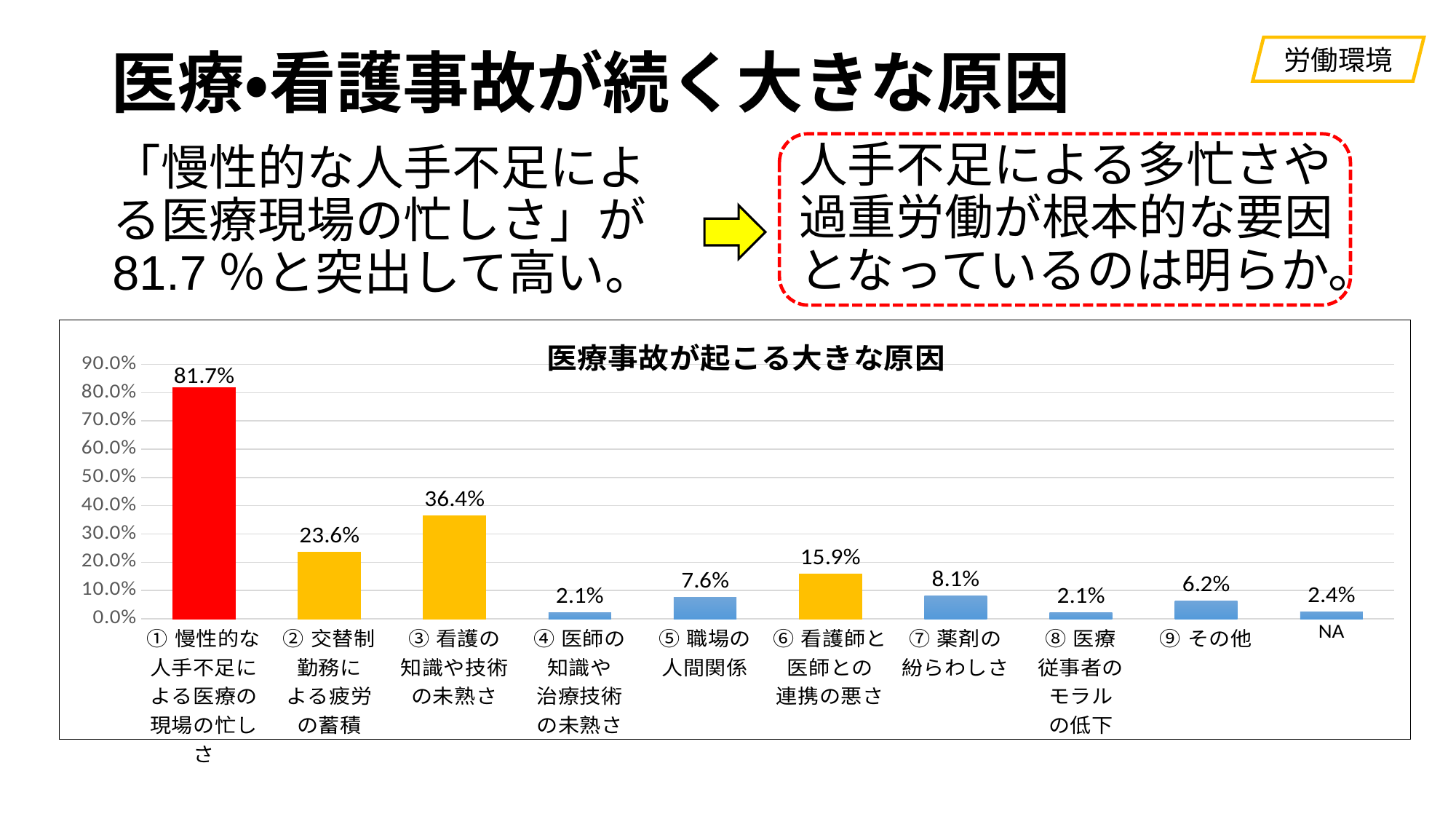
Which is larger, ② 交替制勤務による疲労の蓄積 or ⑥ 看護師と医師との連携の悪さ? ② 交替制勤務による疲労の蓄積 What is the value for NA? 2.4% What is the difference between ① 慢性的な人手不足による医療現場の忙しさ and ③ 看護の知識や技術の未熟さ? 45.3% What colour is the bar for ① 慢性的な人手不足による医療現場の忙しさ? red What is the value for ① 慢性的な人手不足による医療現場の忙しさ? 81.7% What is the title of the chart? 医療事故が起こる大きな原因 What is the value for ③ 看護の知識や技術の未熟さ? 36.4% What type of chart is shown on the slide? bar chart Is the value for ⑦ 薬剤の紛らわしさ greater or less than 10.0%? less Which category has the highest value? ① 慢性的な人手不足による医療現場の忙しさ What is the value for ⑥ 看護師と医師との連携の悪さ? 15.9% How many categories are plotted in the chart? 10